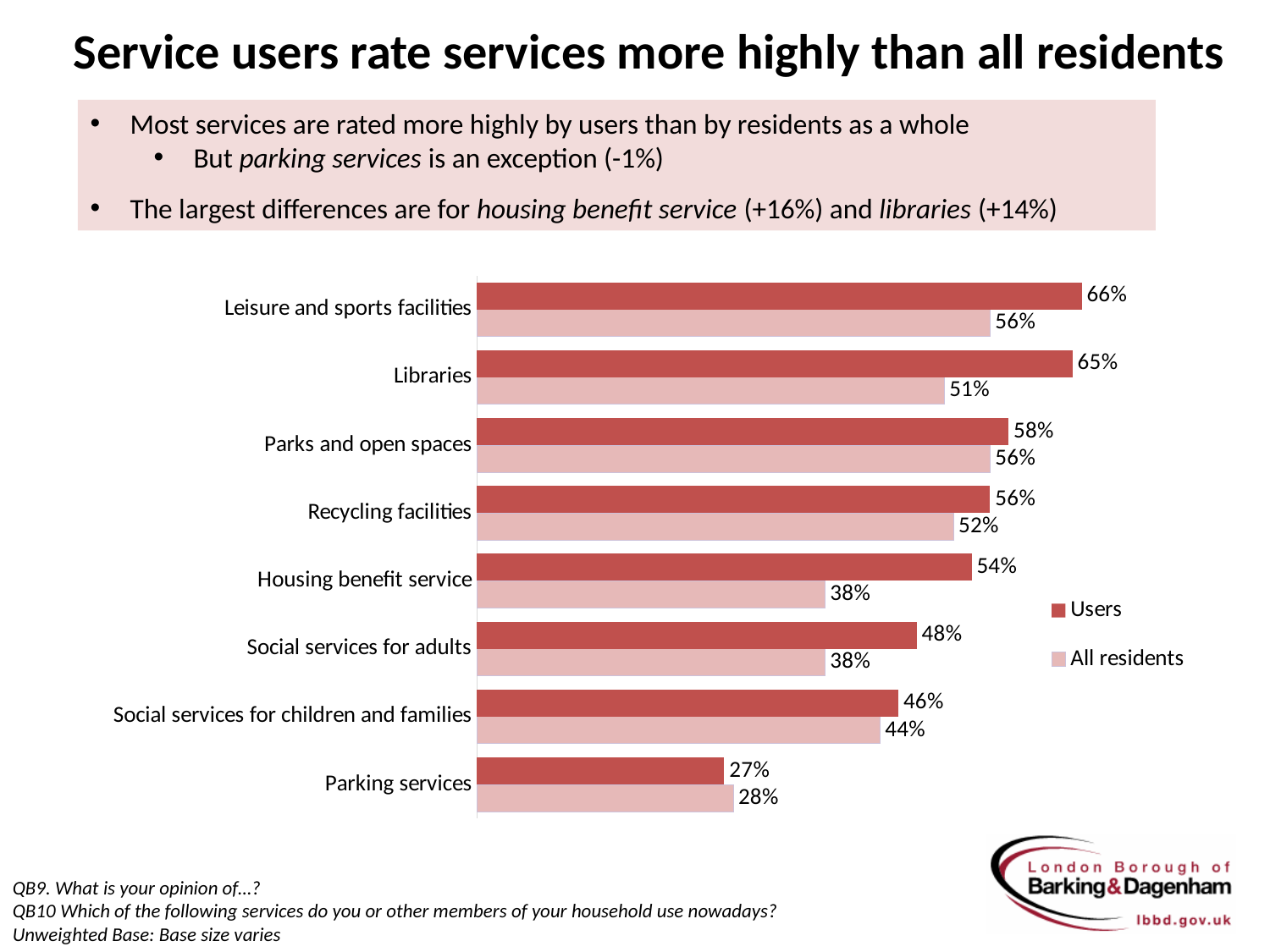
What is the Users value for Libraries? 65% How many series does the legend list? 2 Which series is shown in the darker red colour? Users Which category has the highest Users value? Leisure and sports facilities What is the difference between the Users and All residents values for Housing benefit service? 16% How many service categories are shown in the chart? 8 Which category has the lowest All residents value? Parking services For Parking services, which is larger: the Users value or the All residents value? All residents What is the All residents value for Housing benefit service? 38% What kind of chart is shown on the slide? Bar chart What is the Users value for Parking services? 27% What is the difference between the Users and All residents values for Libraries? 14%